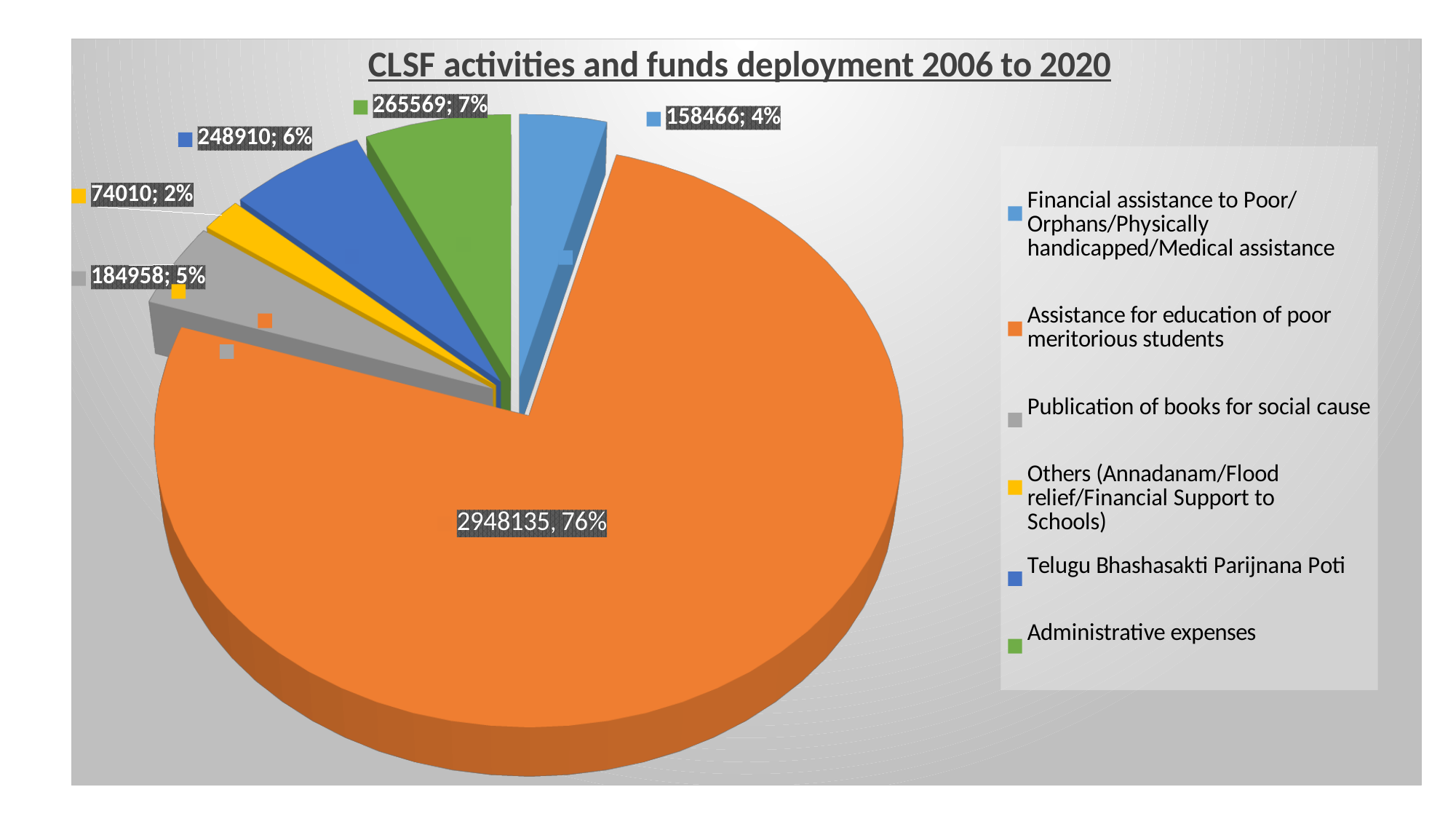
What value is shown for Assistance for education of poor meritorious students? 2948135 What is the title of the chart? CLSF activities and funds deployment 2006 to 2020 What kind of chart is shown on the slide? Pie chart What value is shown for Administrative expenses? 265569 Which category has the smallest slice? Others (Annadanam/Flood relief/Financial Support to Schools) What is the difference between the values for Administrative expenses and Telugu Bhashasakti Parijnana Poti? 16659 What value is shown for Telugu Bhashasakti Parijnana Poti? 248910 What share of the pie does Others (Annadanam/Flood relief/Financial Support to Schools) represent? 2% How many categories does the pie chart have? 6 What share of the pie does Publication of books for social cause represent? 5% Which is larger: the value for Publication of books for social cause or the value for Financial assistance to Poor/Orphans/Physically handicapped/Medical assistance? Publication of books for social cause Which category has the largest slice? Assistance for education of poor meritorious students